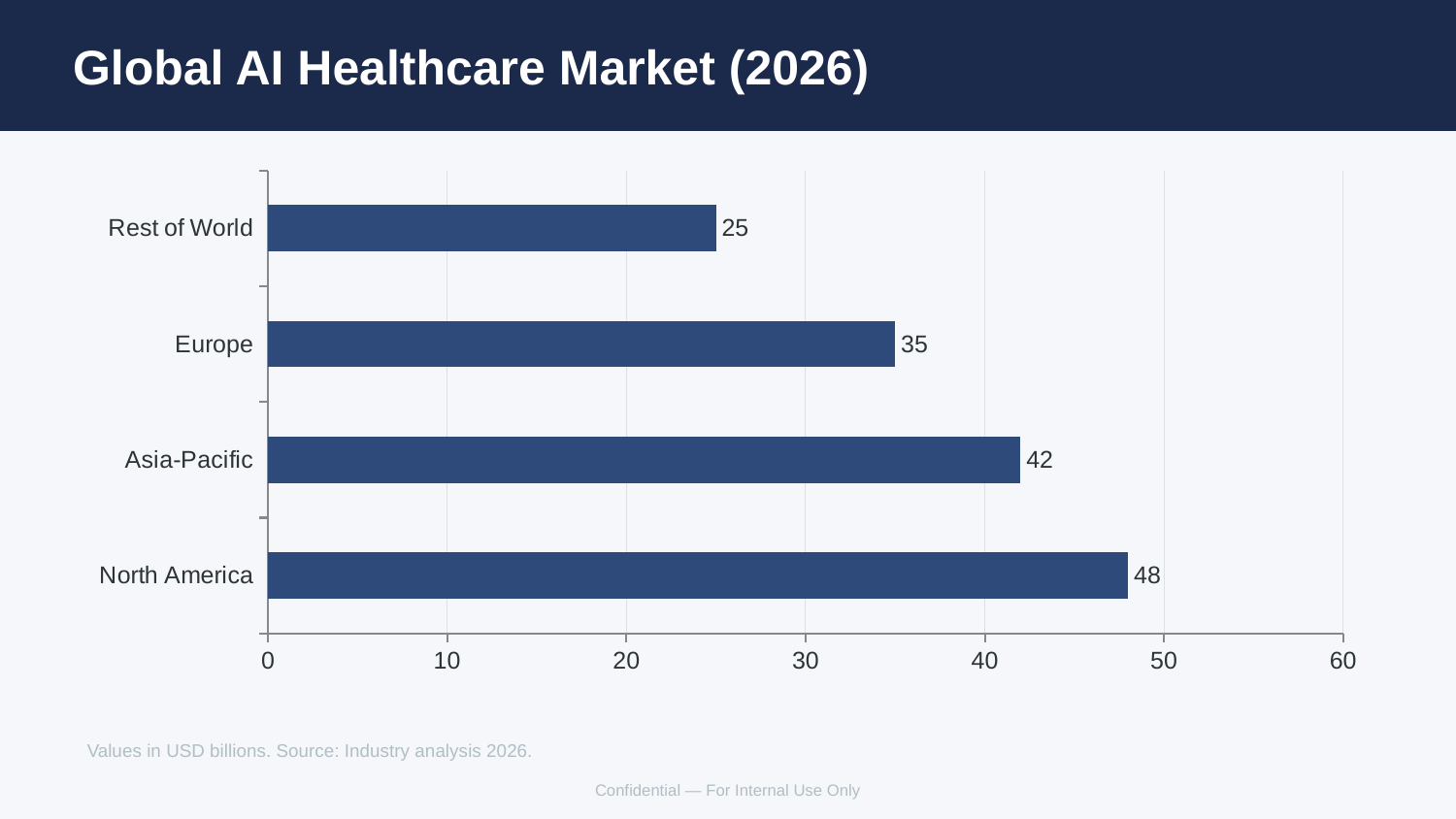
Is the value for Asia-Pacific greater or less than 40? greater How many regions are shown in the chart? 4 Which region has the lowest value? Rest of World Which is larger, the value for Asia-Pacific or the value for Europe? Asia-Pacific What is the value for North America? 48 What is the value for Europe? 35 What kind of chart is shown on the slide? Bar chart What is the difference between the values for Europe and Rest of World? 10 What is the difference between the values for North America and Asia-Pacific? 6 What is the value for Rest of World? 25 What is the title of the chart? Global AI Healthcare Market (2026) Which region has the highest value? North America